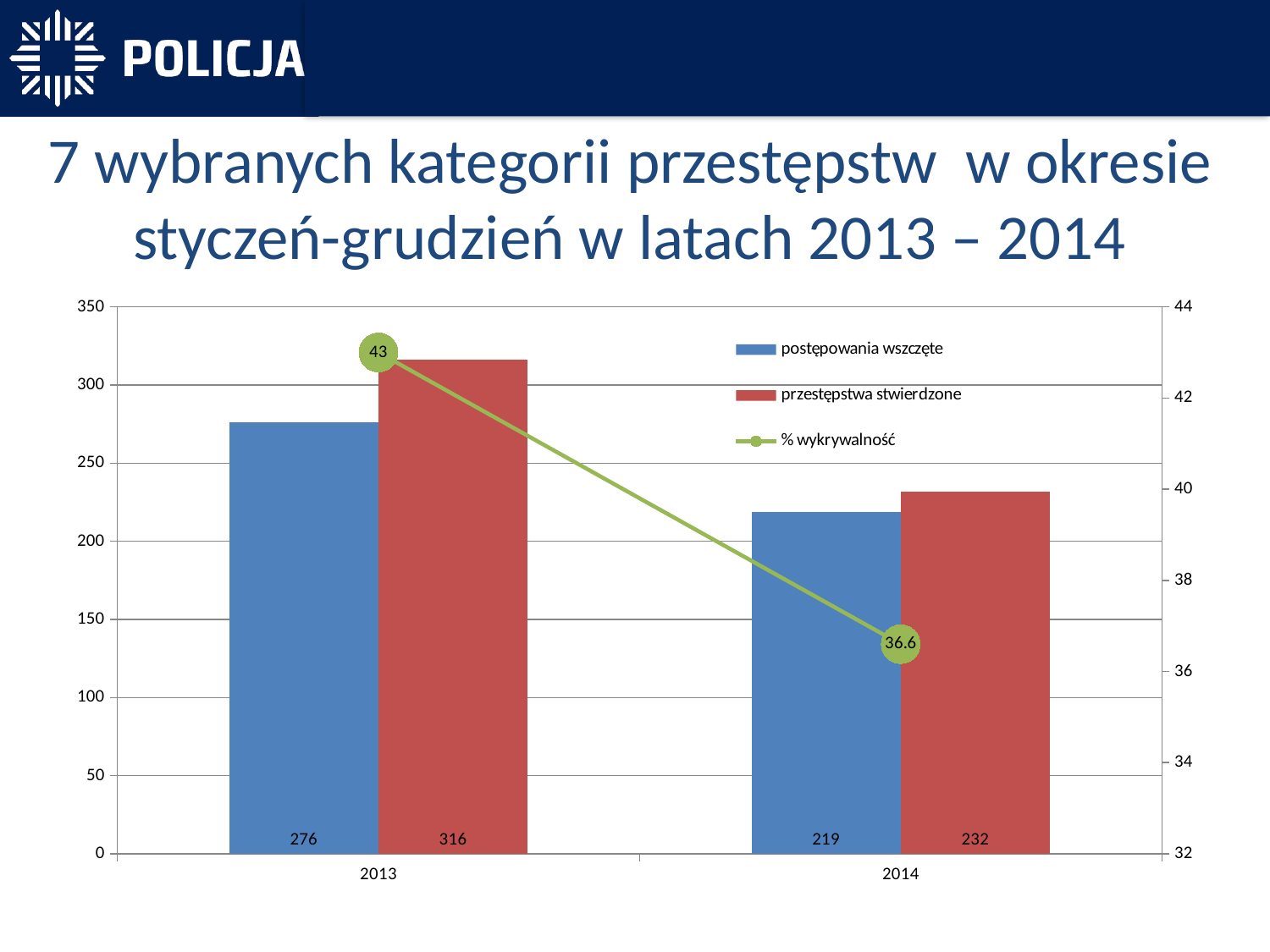
What is the value of przestępstwa stwierdzone in 2014? 232 What is the difference between przestępstwa stwierdzone and postępowania wszczęte in 2014? 13 What is the % wykrywalność value for 2014? 36.6 In which year is postępowania wszczęte lowest? 2014 Which is larger in 2013: postępowania wszczęte or przestępstwa stwierdzone? przestępstwa stwierdzone In which year is przestępstwa stwierdzone highest? 2013 How many years are shown on the x axis? 2 Does the % wykrywalność line rise or fall from 2013 to 2014? fall What is the value of postępowania wszczęte in 2013? 276 How many series does the legend list? 3 What is the % wykrywalność value for 2013? 43 What is the difference between przestępstwa stwierdzone in 2013 and 2014? 84